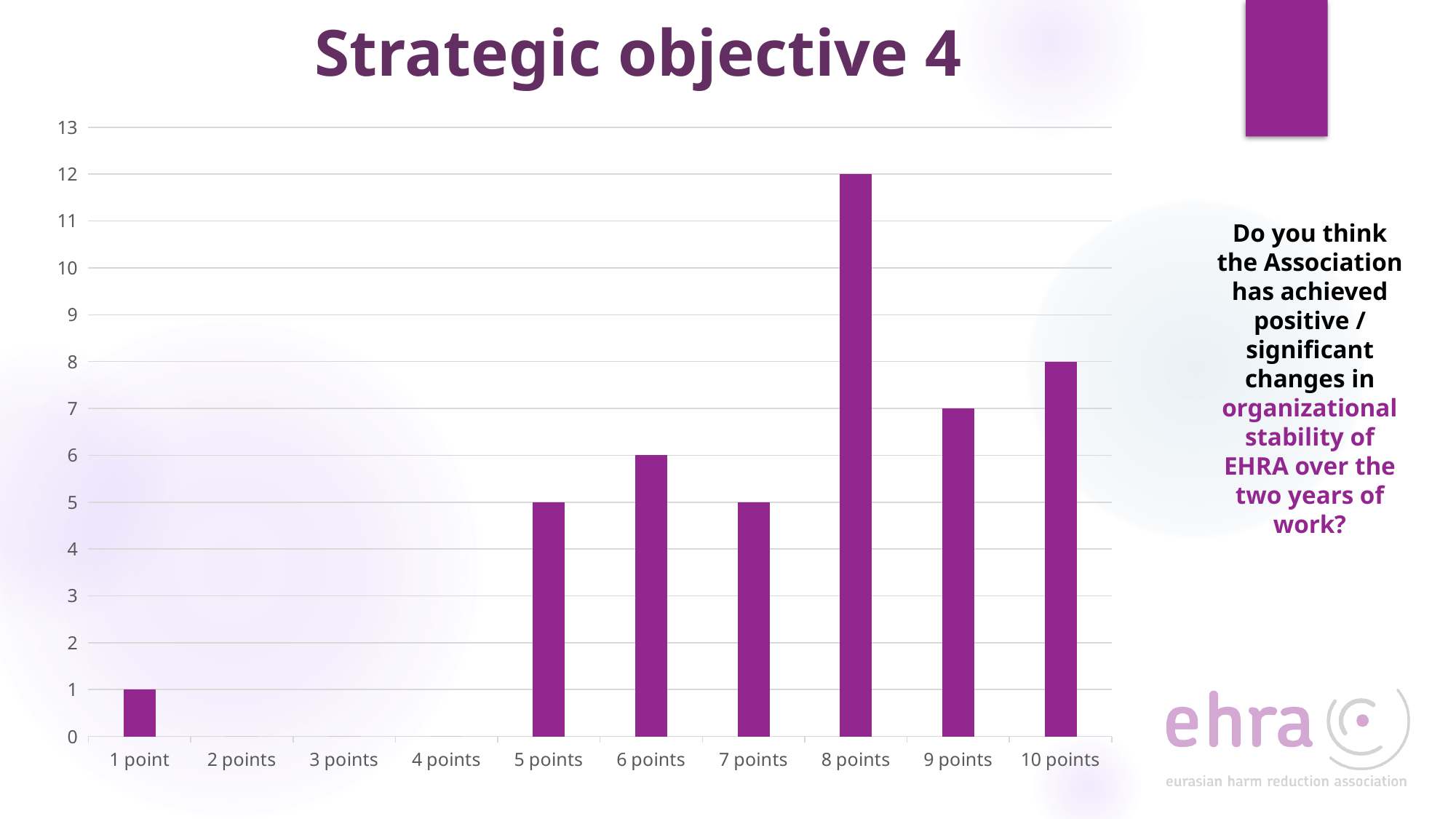
What is the difference between the values for 8 points and 9 points? 5 Is the value for 8 points greater or less than 10? greater What is the value for 9 points? 7 Which is larger, the value for 6 points or the value for 7 points? 6 points What kind of chart is shown on the slide? bar chart What is the title of the chart? Strategic objective 4 Which category has the highest value? 8 points Which category with a visible bar has the lowest value? 1 point What is the value for 10 points? 8 How many categories are shown on the x axis? 10 What is the value for 8 points? 12 What is the value for 1 point? 1